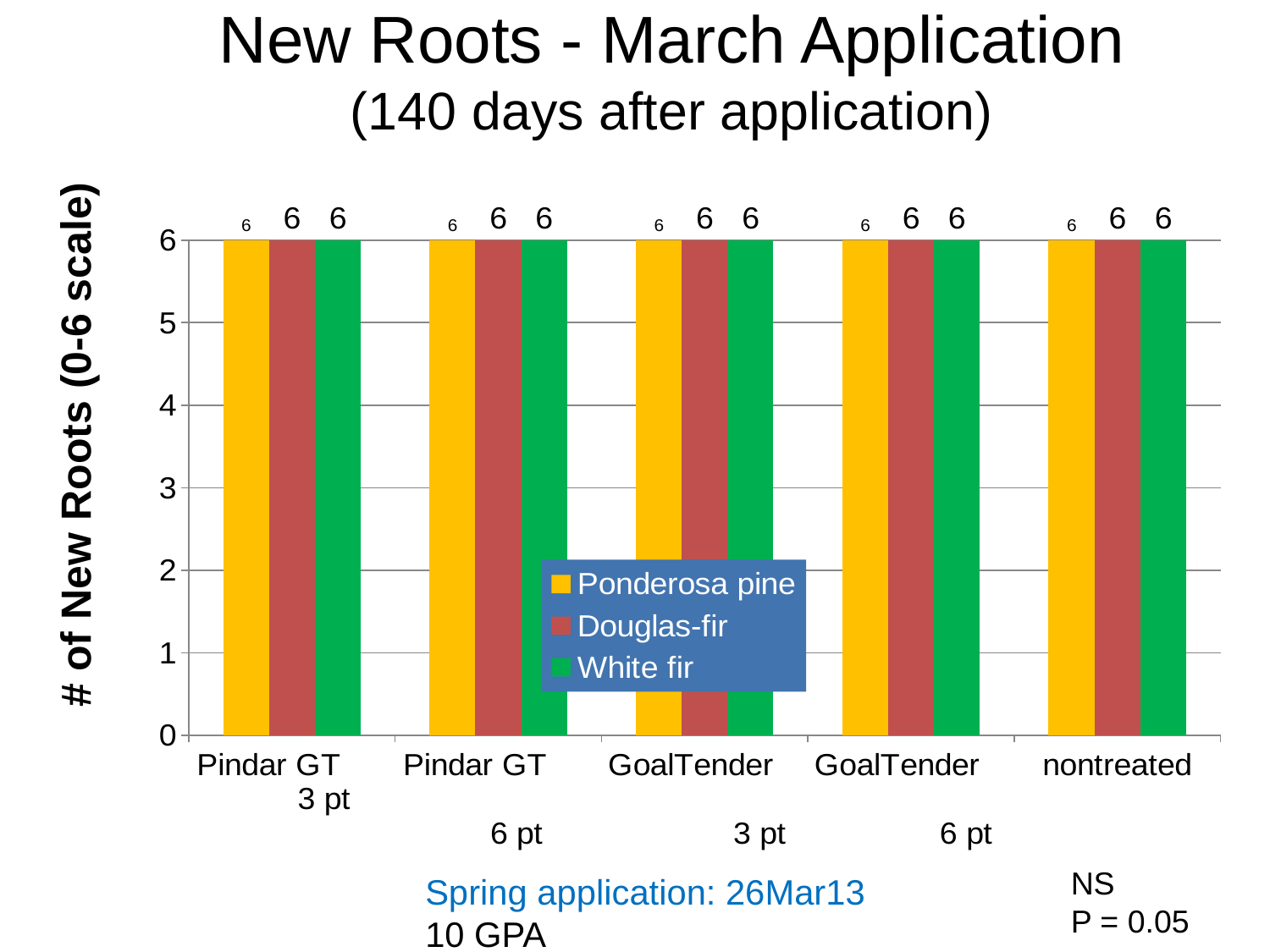
Which series is shown in green in the legend? White fir What is the value for Ponderosa pine in the nontreated category? 6 What is the value for Douglas-fir in the GoalTender 3 pt category? 6 What kind of chart is shown on the slide? bar chart How many series does the legend list? 3 Is the value for White fir in the GoalTender 3 pt category greater or less than 3? greater What is the title of the chart? New Roots - March Application (140 days after application) What is the value for Ponderosa pine in the Pindar GT 3 pt category? 6 Do the Douglas-fir values rise, fall, or stay the same across the categories from left to right? stay the same What is the value for White fir in the Pindar GT 6 pt category? 6 What is the difference between the White fir value for GoalTender 6 pt and the Douglas-fir value for nontreated? 0 How many treatment categories are shown on the x axis? 5